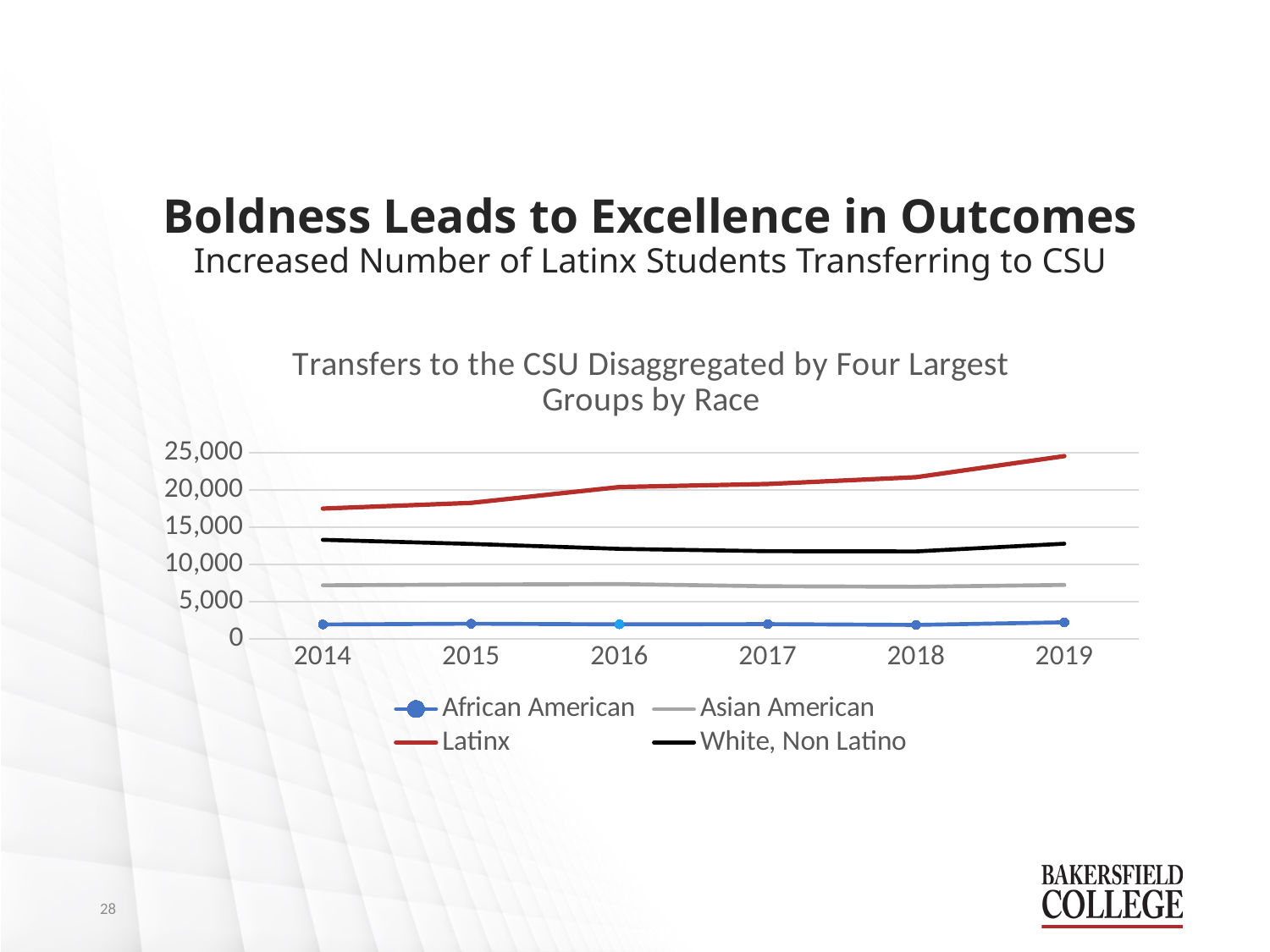
Which group has the highest number of transfers in 2019? Latinx How many series does the legend list? 4 Is the value for White, Non Latino in 2014 greater or less than 15,000? less What is the title of the chart? Transfers to the CSU Disaggregated by Four Largest Groups by Race Is the value for Latinx in 2014 greater or less than 20,000? less Do the Latinx transfers rise or fall from 2014 to 2019? Rise Is the value for Latinx in 2019 greater or less than 20,000? greater In 2017, which is larger: White, Non Latino or Asian American? White, Non Latino How many years are plotted along the x axis? 6 What kind of chart is shown on the slide? Line chart Which group has the lowest number of transfers in 2014? African American